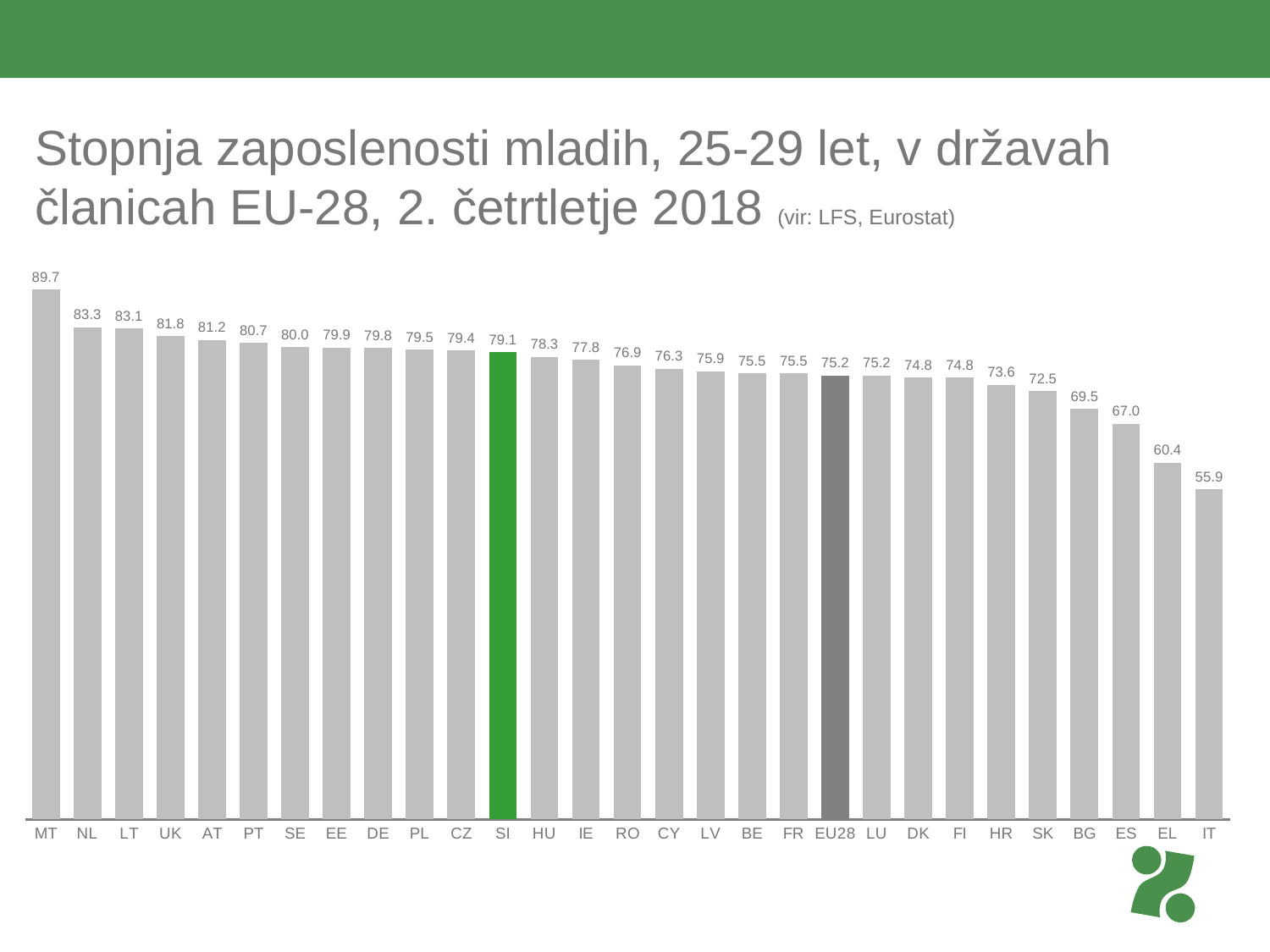
Which bar is coloured green? SI How many bars are shown in the chart? 29 What is the value for EU28? 75.2 What is the difference between the values for SI and EU28? 3.9 What kind of chart is shown on the slide? Bar chart Which country has the lowest value? IT What is the difference between the values for MT and IT? 33.8 What is the value for SI? 79.1 Do the values rise or fall from left to right along the x axis? Fall Which is larger, the value for NL or the value for ES? NL What is the value for IT? 55.9 Which country has the highest value? MT